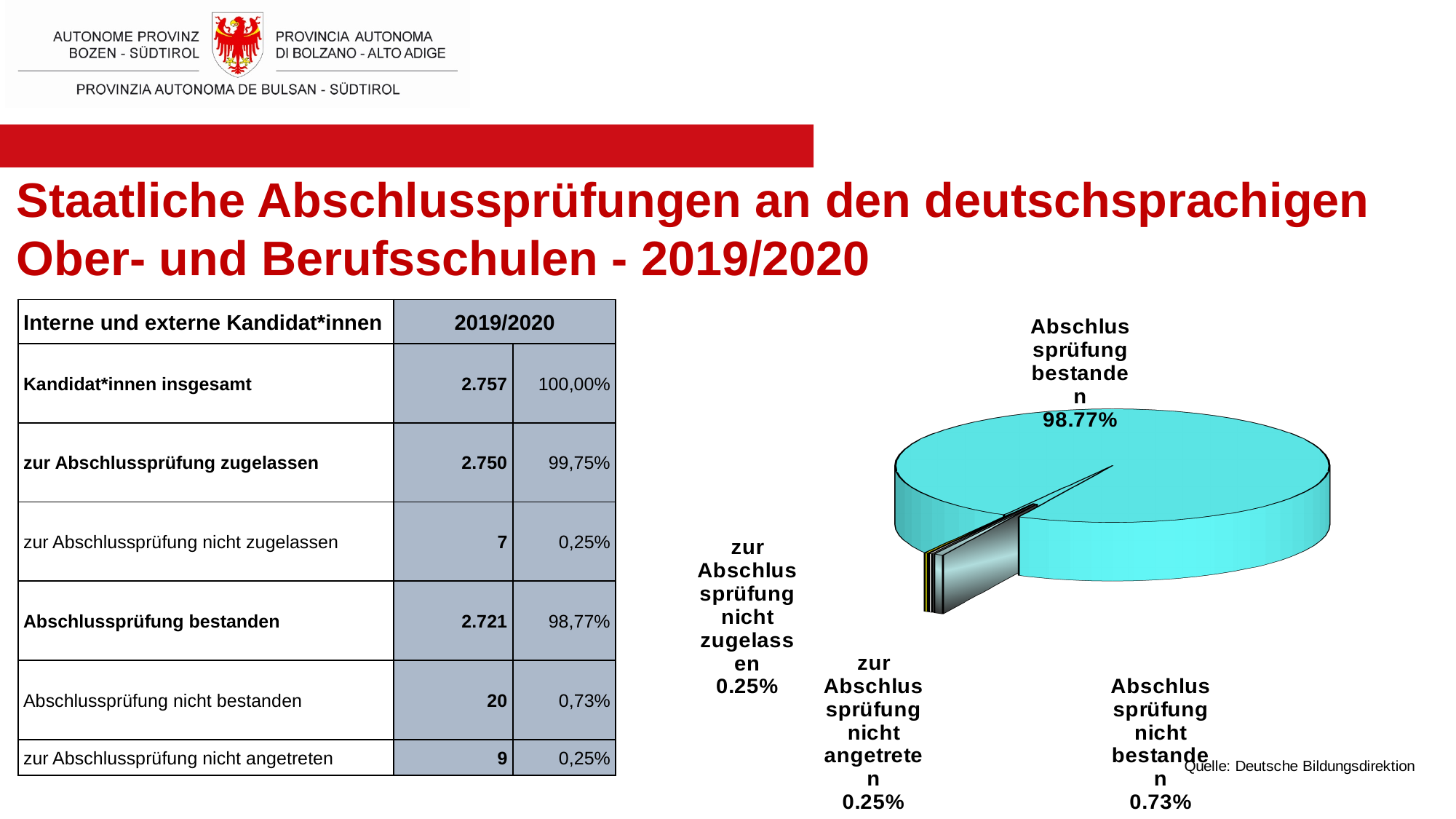
What share of the pie does "Abschlussprüfung bestanden" have? 98.77% How many slices does the pie chart have? 4 What share of the pie does "zur Abschlussprüfung nicht zugelassen" have? 0.25% What share of the pie does "zur Abschlussprüfung nicht angetreten" have? 0.25% What is the difference between the shares of "Abschlussprüfung nicht bestanden" and "zur Abschlussprüfung nicht angetreten" in the pie chart? 0.48% Which slice of the pie chart is the largest? Abschlussprüfung bestanden Is the share of "Abschlussprüfung bestanden" in the pie chart greater or less than 90%? greater Which is larger in the pie chart: "Abschlussprüfung nicht bestanden" or "zur Abschlussprüfung nicht zugelassen"? Abschlussprüfung nicht bestanden What colour is the largest slice of the pie chart? light blue (cyan) What kind of chart is shown on the slide? pie chart What is the source cited below the pie chart? Quelle: Deutsche Bildungsdirektion